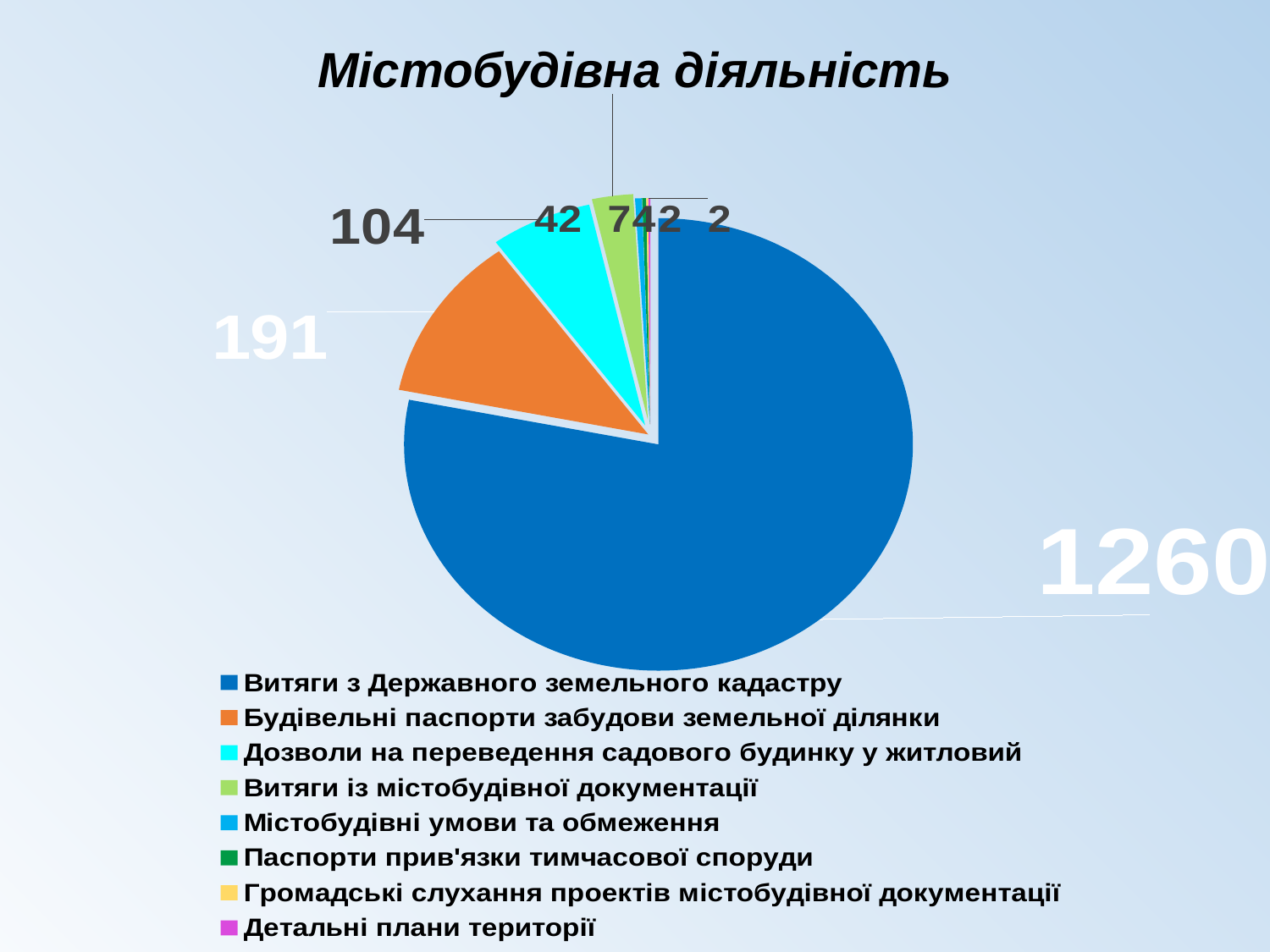
How many categories does the legend list? 8 What colour is the slice for Будівельні паспорти забудови земельної ділянки? orange What is the difference between the values for Витяги з Державного земельного кадастру and Будівельні паспорти забудови земельної ділянки? 1069 What is the value for Дозволи на переведення садового будинку у житловий? 104 What is the title of the chart? Містобудівна діяльність What is the value for Будівельні паспорти забудови земельної ділянки? 191 What is the difference between the values for Будівельні паспорти забудови земельної ділянки and Дозволи на переведення садового будинку у житловий? 87 What is the value for Витяги із містобудівної документації? 42 Which is larger: the value for Дозволи на переведення садового будинку у житловий or the value for Витяги із містобудівної документації? Дозволи на переведення садового будинку у житловий Which category has the largest slice of the pie? Витяги з Державного земельного кадастру What kind of chart is shown on the slide? pie chart What is the value for Витяги з Державного земельного кадастру? 1260